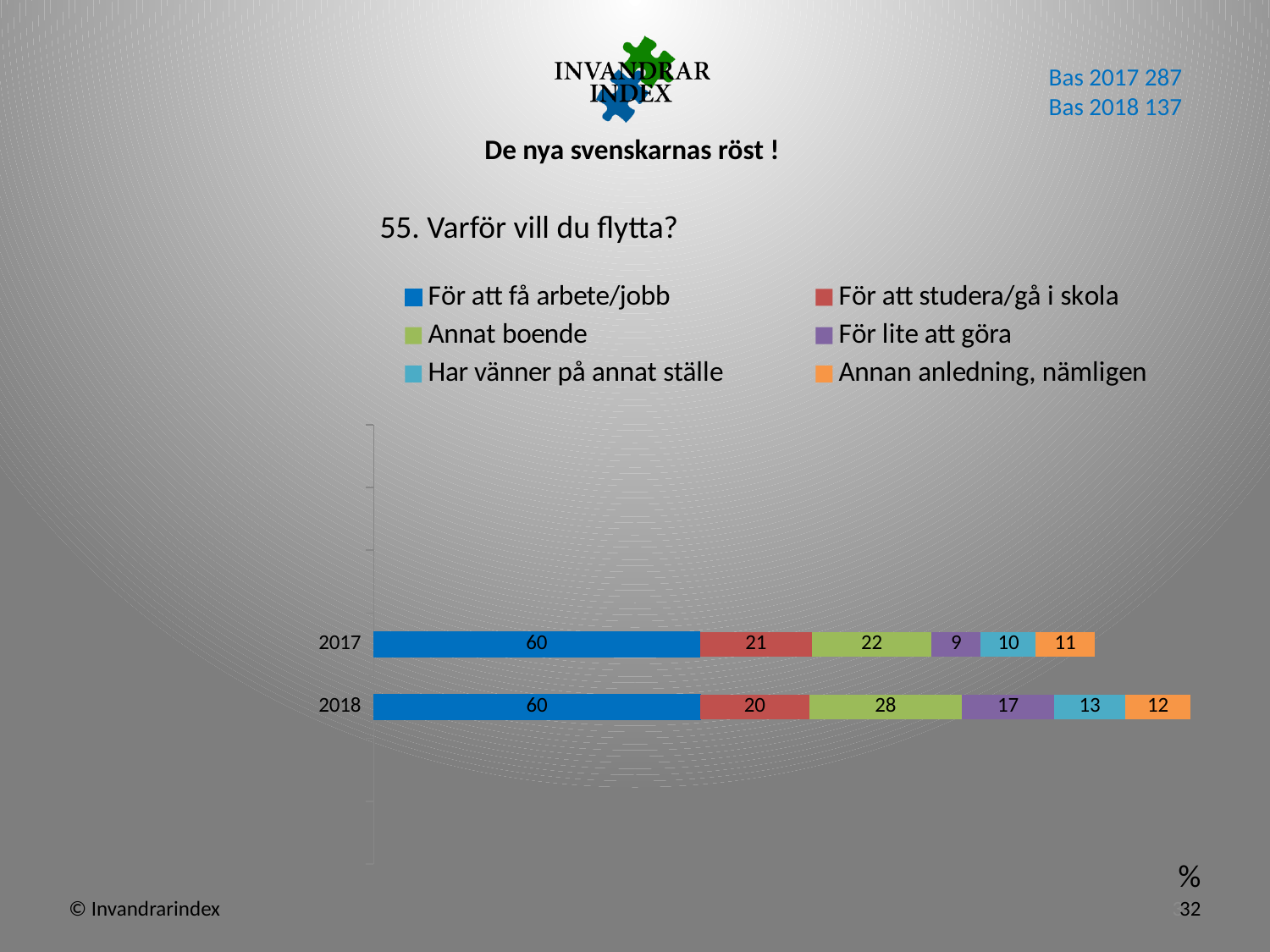
What is the value for "För lite att göra" in 2018? 17 What is the value for "Annat boende" in 2017? 22 What is the difference between the "Annat boende" values for 2018 and 2017? 6 Which is larger: "För lite att göra" in 2017 or in 2018? 2018 Which series has the lowest value in the 2017 bar? För lite att göra What is the value for "Annan anledning, nämligen" in 2018? 12 What is the total of the stacked bar for 2018? 150 What is the value for "Har vänner på annat ställe" in 2017? 10 Which series has the highest value in the 2017 bar? För att få arbete/jobb What is the value for "För att få arbete/jobb" in 2018? 60 What kind of chart is shown on the slide? Stacked bar chart How many series does the legend list? 6